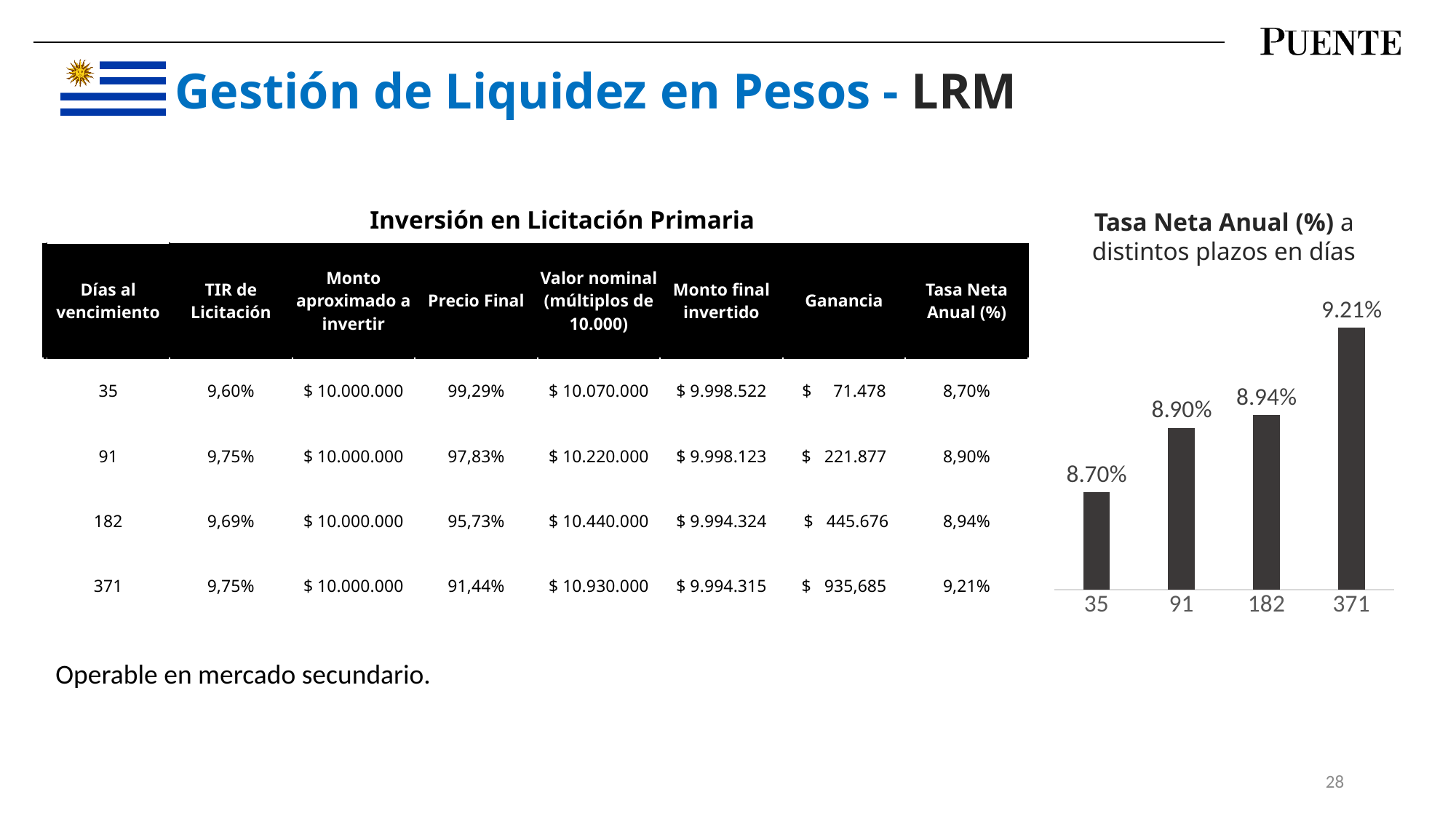
What is the Tasa Neta Anual for the 91-day term in the chart? 8.90% What type of chart is shown on the slide? bar chart Which term has the lowest Tasa Neta Anual in the chart? 35 What is the Tasa Neta Anual for the 371-day term in the chart? 9.21% What is the Tasa Neta Anual for the 182-day term in the chart? 8.94% Which has a higher Tasa Neta Anual, the 91-day term or the 371-day term? 371 What is the difference between the Tasa Neta Anual for 371 days and for 35 days? 0.51% Do the values in the chart rise or fall as the term in days increases? rise How many terms (bars) are shown in the chart? 4 What is the Tasa Neta Anual for the 35-day term in the chart? 8.70% What is the difference between the Tasa Neta Anual for 182 days and for 91 days? 0.04% Which term has the highest Tasa Neta Anual in the chart? 371